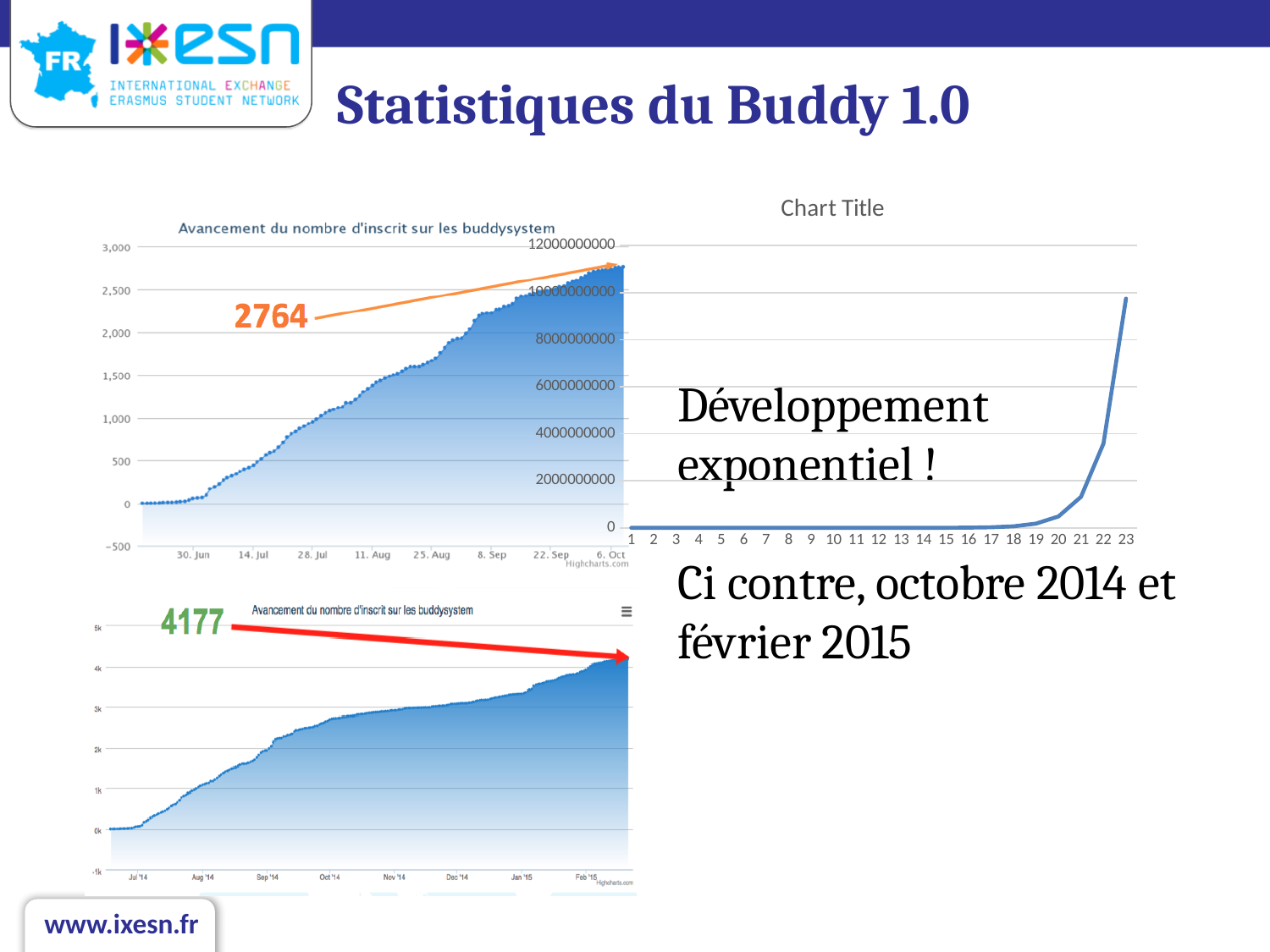
On the top-left chart, is the value at 6. Oct greater or less than 2,500? greater On the right chart titled 'Chart Title', how many points are labelled on the x axis? 23 On the right chart titled 'Chart Title', is the value at point 23 greater or less than 8000000000? greater On the top-left chart, is the value at 30. Jun greater or less than 500? less What kind of chart is the chart on the right titled 'Chart Title'? line chart What is the title shown above the chart on the right? Chart Title On the right chart titled 'Chart Title', do the values rise or fall along the x axis? rise On the bottom-left chart, what value is annotated at the end of the curve? 4177 On the top-left chart, what value is annotated at the end of the curve? 2764 What is the title of the top-left chart? Avancement du nombre d'inscrit sur les buddysystem